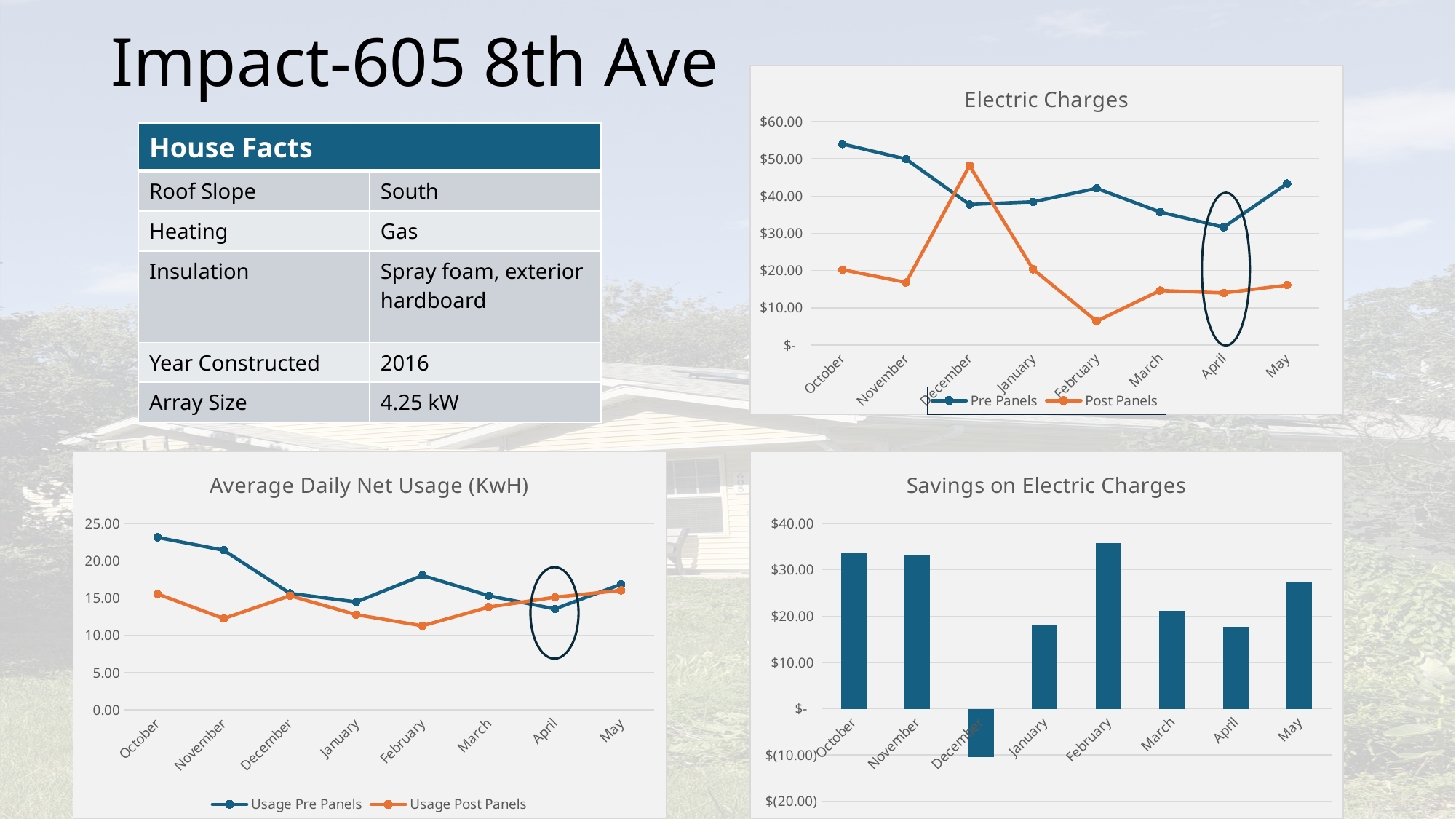
In the "Average Daily Net Usage (KwH)" chart, is the Usage Pre Panels value for October greater or less than 20.00? greater In the "Savings on Electric Charges" chart, which month has the lowest value? December In the "Average Daily Net Usage (KwH)" chart, which month has the lowest Usage Post Panels value? February What kind of chart is the "Savings on Electric Charges" chart? bar chart In the "Electric Charges" chart, which month has the lowest Post Panels value? February In the "Electric Charges" chart, is the Pre Panels value for October greater or less than $50.00? greater How many series does the legend of the "Electric Charges" chart list? 2 In the "Average Daily Net Usage (KwH)" chart, which month has the highest Usage Pre Panels value? October In the "Electric Charges" chart, which series has the higher value in December, Pre Panels or Post Panels? Post Panels How many months are shown on the x axis of the "Savings on Electric Charges" chart? 8 In the "Electric Charges" chart, which month has the highest Pre Panels value? October What kind of chart is the "Electric Charges" chart? line chart